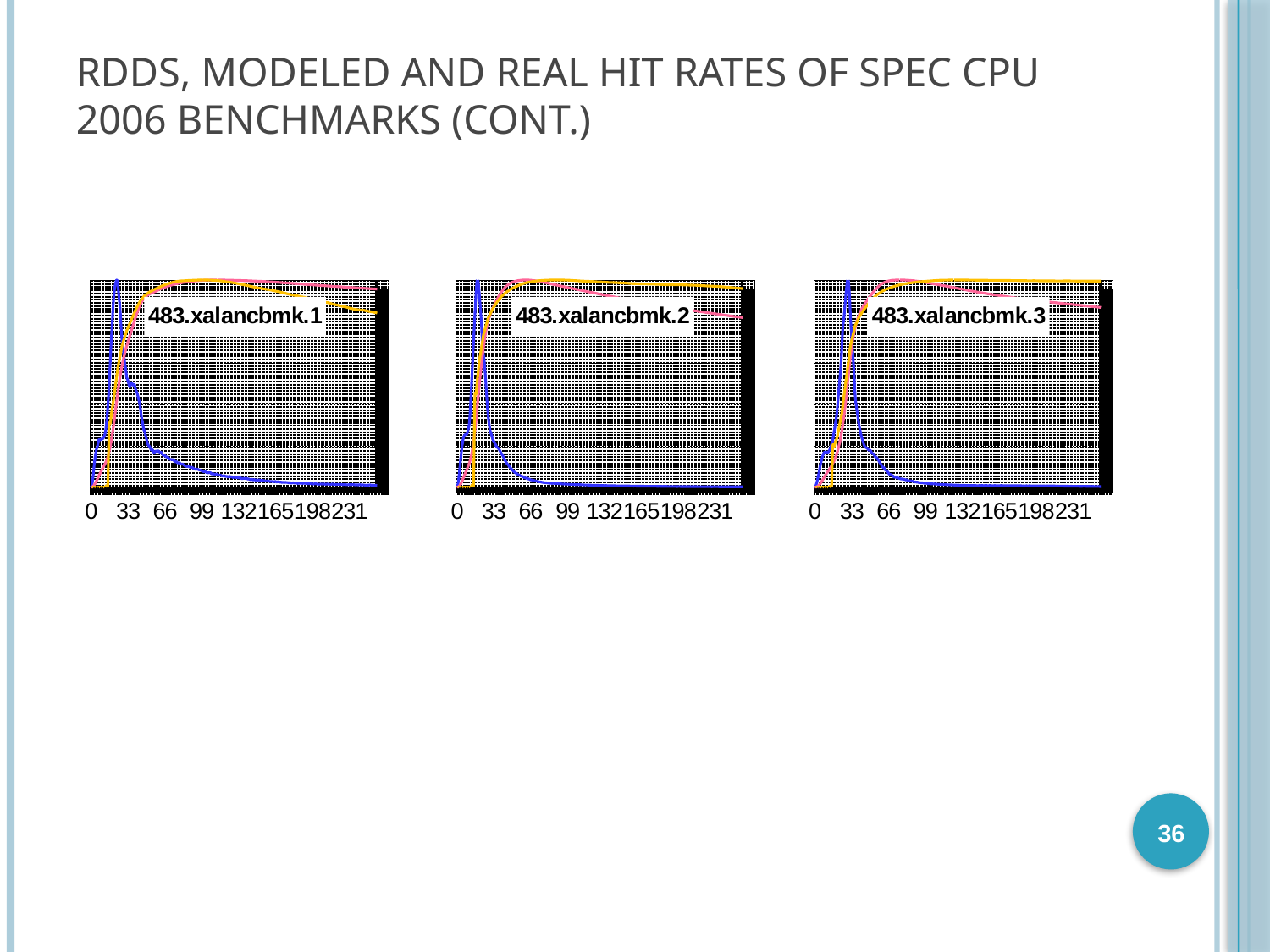
In the chart titled 483.xalancbmk.2, does the orange line rise or fall along the x axis from 0 to 33? rise What kind of chart is the chart titled 483.xalancbmk.1? line chart In the chart titled 483.xalancbmk.1, does the blue line rise or fall along the x axis after its early peak? fall What kind of chart is the chart titled 483.xalancbmk.3? line chart What is the title of the middle chart on the slide? 483.xalancbmk.2 In the chart titled 483.xalancbmk.3, does the blue line rise or fall along the x axis from 66 to 231? fall How many charts are shown on the slide? 3 In the chart titled 483.xalancbmk.3, what is the first tick label on the x axis? 0 In the chart titled 483.xalancbmk.1, what is the largest tick label on the x axis? 231 In the chart titled 483.xalancbmk.2, how many tick labels are printed on the x axis? 8